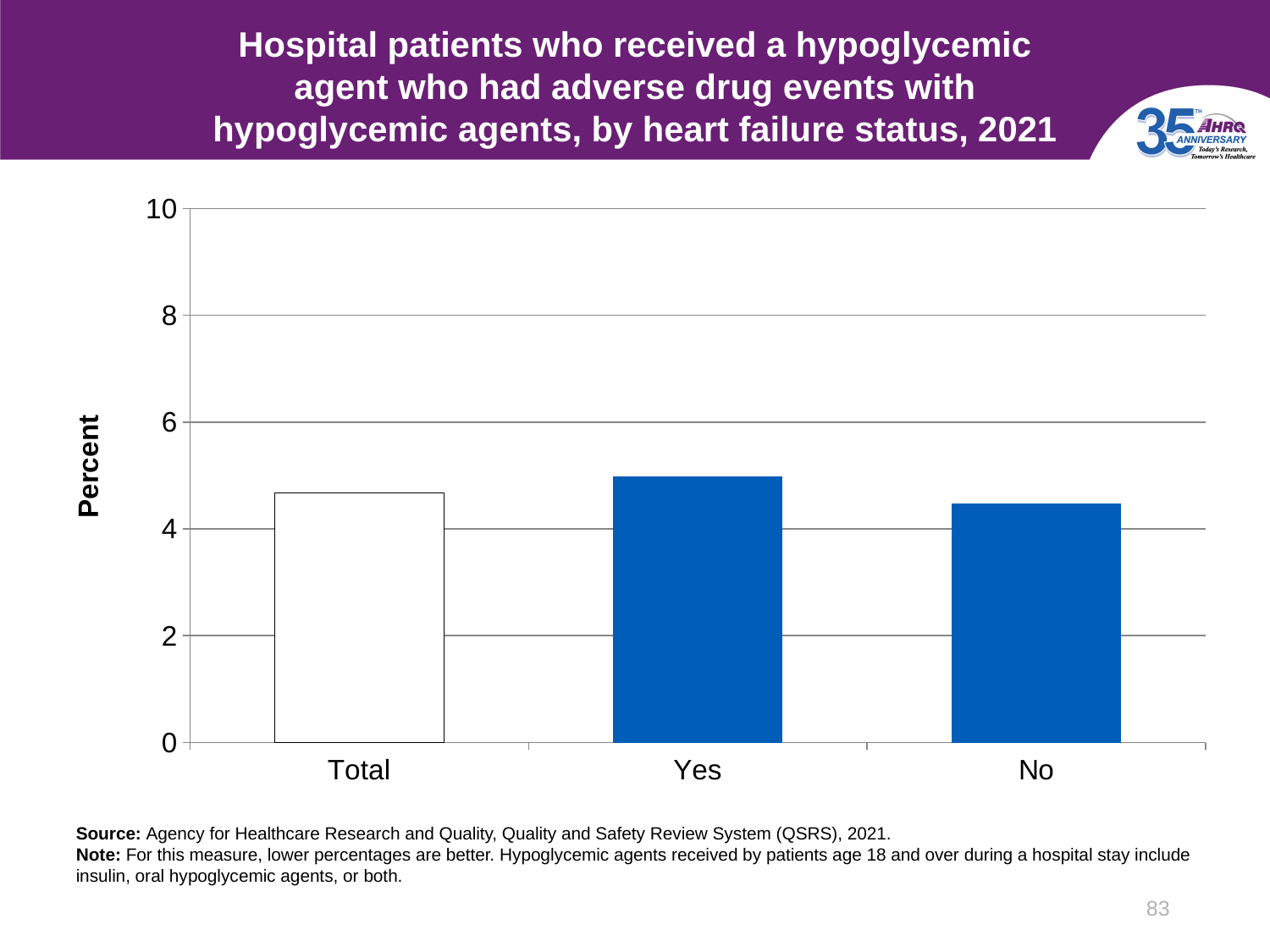
How many categories are shown on the x axis of the chart? 3 What is the maximum value shown on the y axis? 10 What kind of chart is shown on the slide? bar chart Is the value for Yes greater or less than 6? less Which is larger, the value for Yes or the value for No? Yes Is the value for Total greater or less than 4? greater Is the value for Total greater or less than 6? less What is the label on the y axis of the chart? Percent Which heart failure status category has the highest percentage? Yes